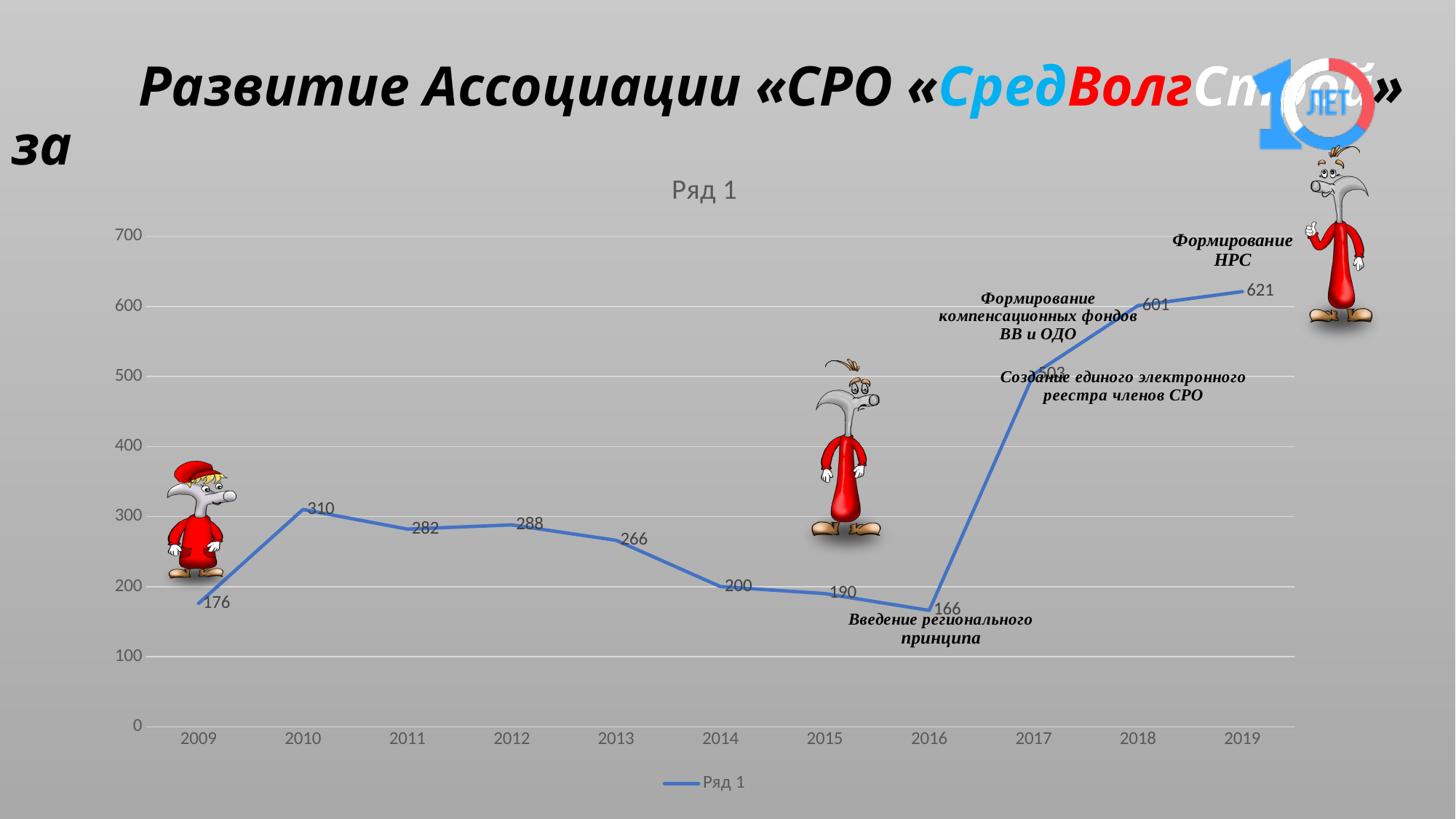
How many years are plotted on the x axis? 11 What is the difference between the values for 2017 and 2016? 337 What is the difference between the values for 2019 and 2018? 20 What is the value for 2016? 166 What is the value for 2009? 176 Which is larger, the value for 2010 or the value for 2013? 2010 Does the value rise or fall from 2016 to 2019? Rise What is the value for 2017? 503 Which year has the lowest value? 2016 What is the name of the series shown in the legend? Ряд 1 What type of chart is shown on the slide? Line chart Which year has the highest value? 2019